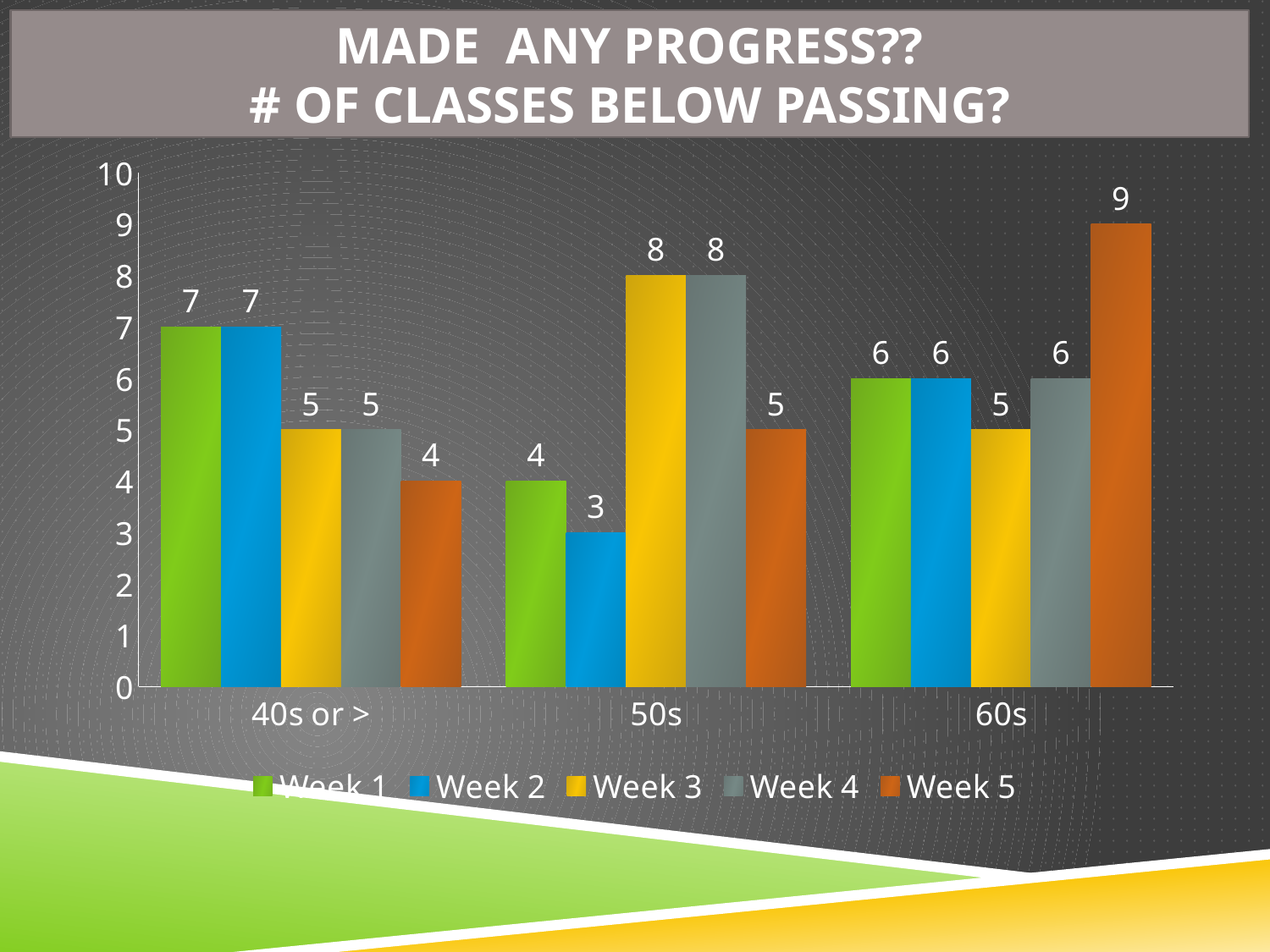
Which is larger: Week 3 in the 50s category or Week 3 in the 60s category? Week 3 in the 50s category Do the values for Week 5 rise or fall from the 40s or > category to the 60s category? Rise What is the title of the chart? MADE ANY PROGRESS?? # OF CLASSES BELOW PASSING? What is the value for Week 5 in the 60s category? 9 What is the difference between Week 1 and Week 5 in the 40s or > category? 3 How many series does the legend list? 5 What is the value for Week 3 in the 40s or > category? 5 How many categories are shown on the x axis? 3 Which week has the lowest value in the 50s category? Week 2 What is the value for Week 2 in the 50s category? 3 Which week has the highest value in the 60s category? Week 5 What kind of chart is shown on the slide? Bar chart